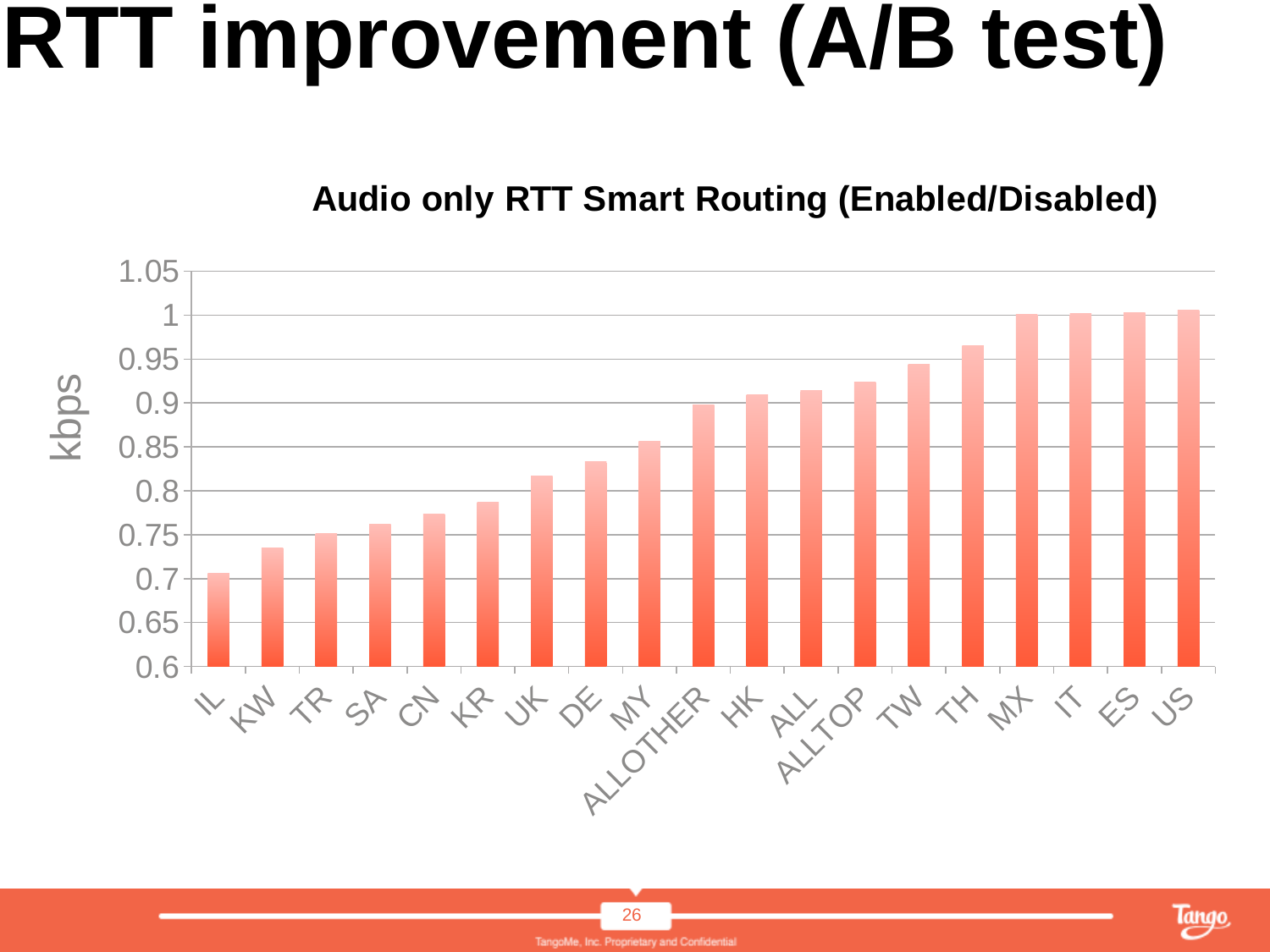
Is the value for UK greater or less than 0.8? greater Is the value for TH greater or less than 0.95? greater Is the value for DE greater or less than 0.85? less Do the values rise or fall moving from left to right along the x axis? rise How many categories are plotted along the x axis? 19 Which category has the lowest value? IL Which has the larger value, US or IL? US What is the title of the chart? Audio only RTT Smart Routing (Enabled/Disabled) What label is shown on the vertical axis of the chart? kbps What kind of chart is shown on the slide? bar chart